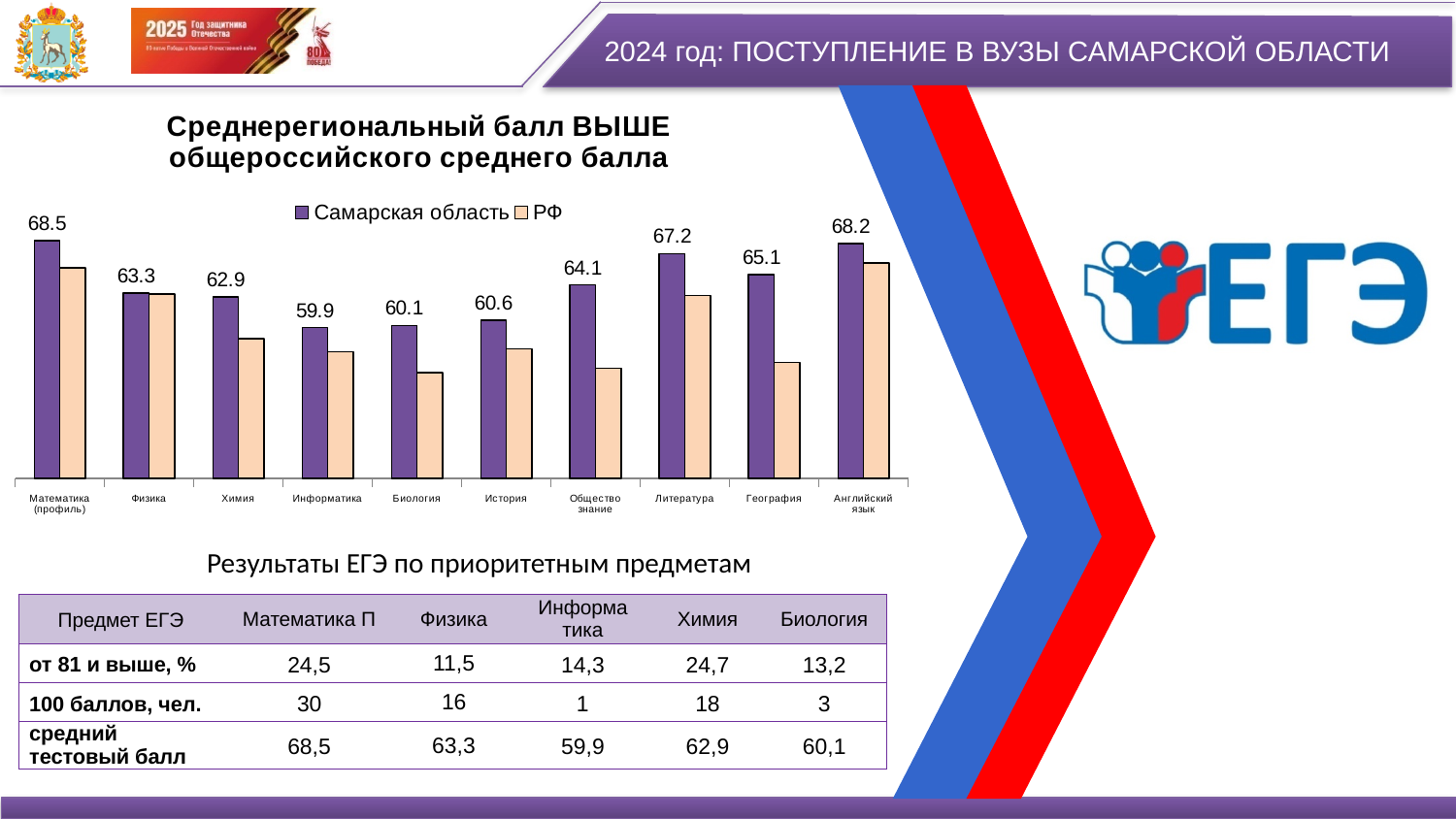
What is the value for Самарская область in Английский язык? 68.2 How many series does the chart legend list? 2 What is the value for Самарская область in Информатика? 59.9 For Химия, which series has the larger value: Самарская область or РФ? Самарская область What is the value for Самарская область in Литература? 67.2 What is the value for Самарская область in Математика (профиль)? 68.5 What kind of chart is shown on the slide? bar chart How many subject categories are shown on the x axis of the chart? 10 What are the two series named in the chart legend? Самарская область and РФ What is the difference between the Самарская область values for Математика (профиль) and Информатика? 8.6 Which subject has the lowest value for Самарская область? Информатика Which subject has the highest value for Самарская область? Математика (профиль)